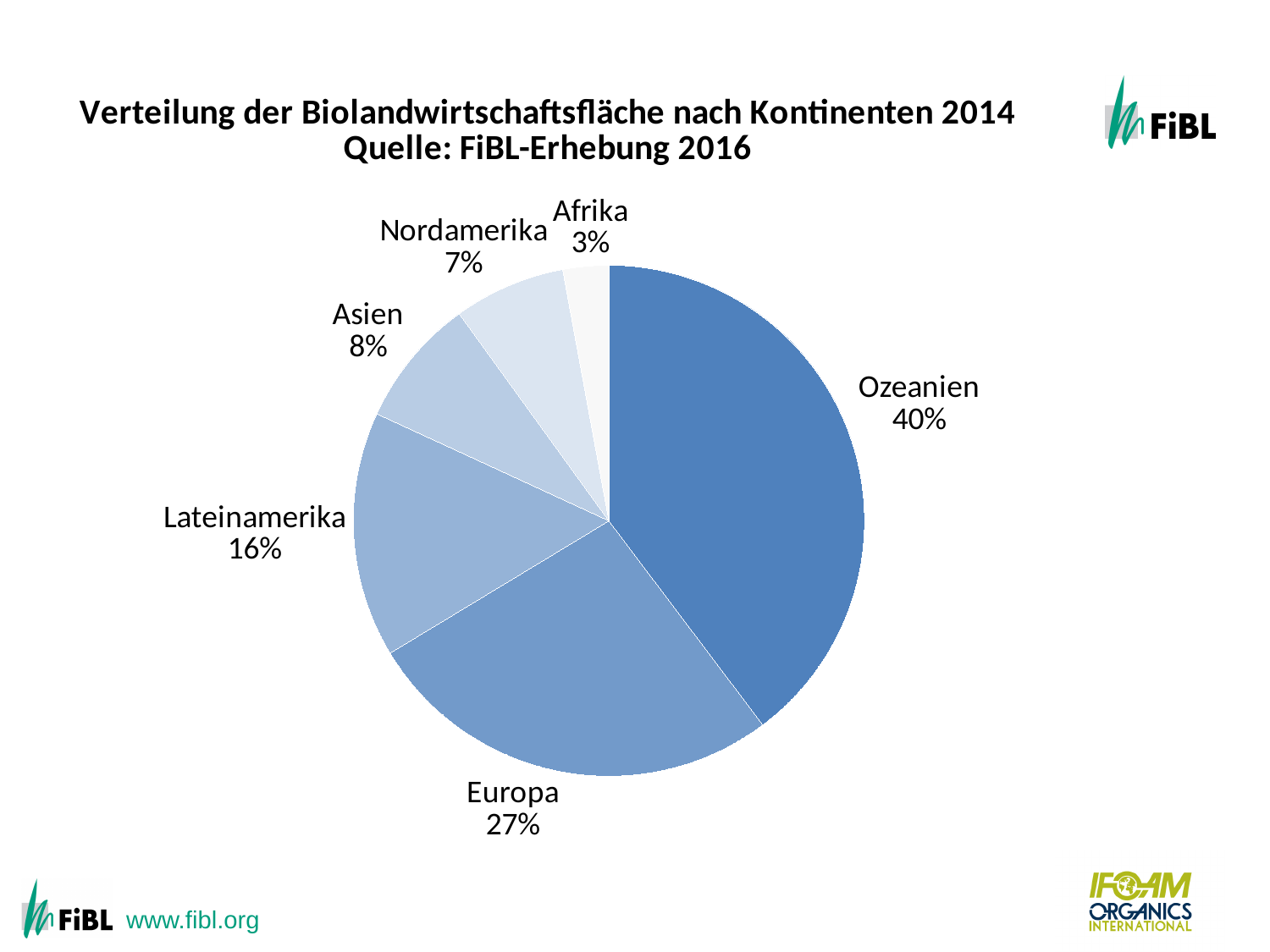
What share of the organic agricultural area does Ozeanien hold? 40% What kind of chart is shown on the slide? pie chart What is the difference in percentage points between Ozeanien and Europa? 13 What percentage is shown for Afrika? 3% Which has a larger share, Asien or Nordamerika? Asien Which continent has the smallest share of the pie? Afrika How many continents (slices) are shown in the pie chart? 6 What percentage is shown for Europa? 27% What is the title of the chart? Verteilung der Biolandwirtschaftsfläche nach Kontinenten 2014 What is the combined share of Asien and Nordamerika? 15% Which continent has the largest share of the pie? Ozeanien What percentage is shown for Lateinamerika? 16%